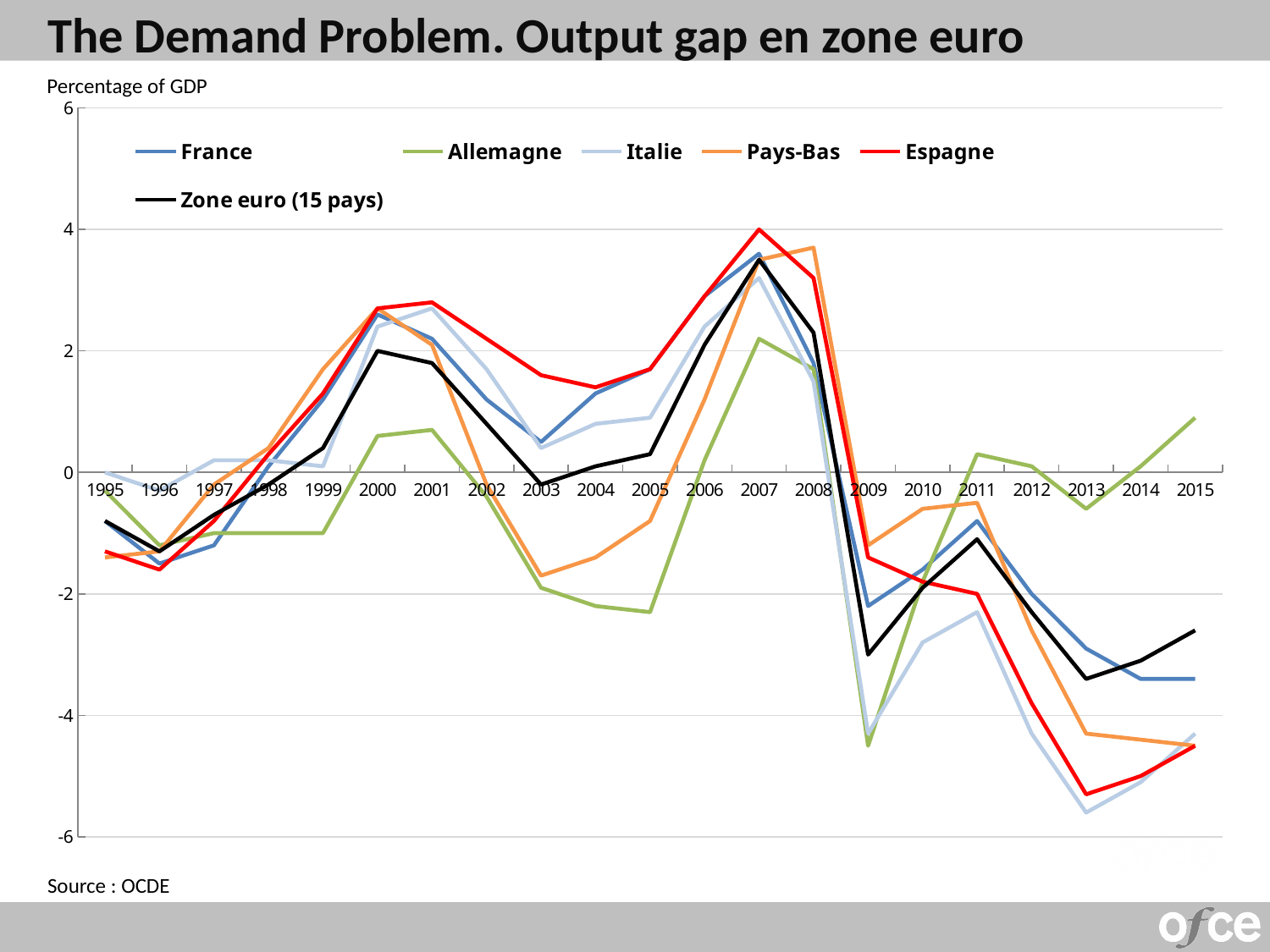
Which series has the highest value in 2007? Espagne How many years are plotted along the x axis? 21 Does the Zone euro (15 pays) line rise or fall between 2007 and 2009? fall Which series has the highest value in 2015? Allemagne How many series does the legend list? 6 Is the value for Allemagne in 2009 greater or less than -4? less Is the value for Zone euro (15 pays) in 2000 greater or less than 1? greater Is the value for Espagne in 2007 greater or less than 3? greater What colour is the Espagne line in the legend? red In 2003, which is larger: the value for France or the value for Allemagne? France What kind of chart is shown on the slide? line chart